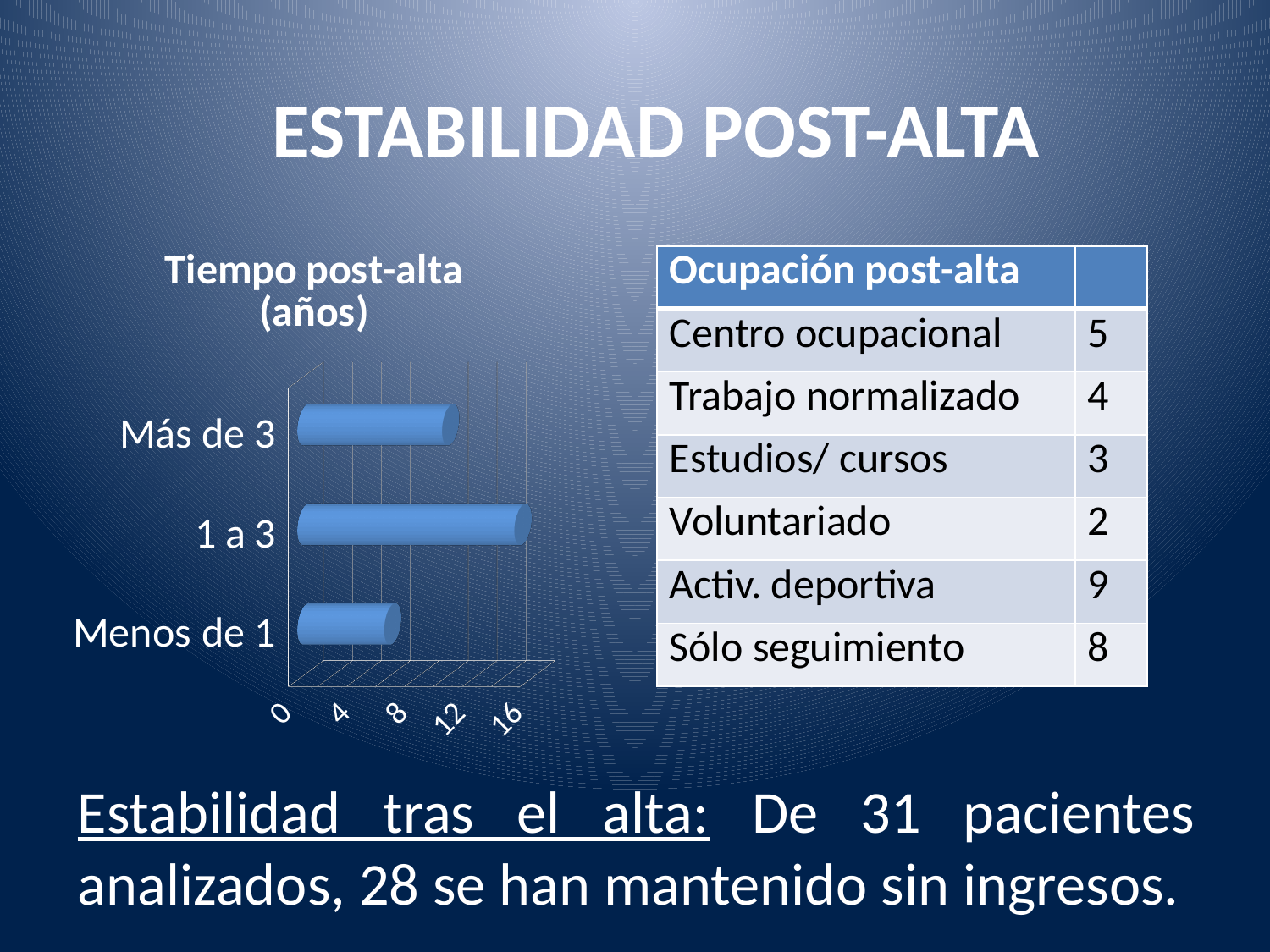
Which category has the lowest value in the "Tiempo post-alta (años)" chart? Menos de 1 What kind of chart is shown under the title "Tiempo post-alta (años)"? bar chart How many categories does the "Tiempo post-alta (años)" chart show? 3 In the "Tiempo post-alta (años)" chart, is the value for "Menos de 1" greater or less than 12? less What is the title of the chart on the slide? Tiempo post-alta (años) In the "Tiempo post-alta (años)" chart, is the value for "Menos de 1" greater or less than 4? greater In the "Tiempo post-alta (años)" chart, is the value for "1 a 3" greater or less than 12? greater In the "Tiempo post-alta (años)" chart, which is larger: the value for "1 a 3" or the value for "Más de 3"? 1 a 3 What is the highest tick value shown on the value axis of the "Tiempo post-alta (años)" chart? 16 Which category has the highest value in the "Tiempo post-alta (años)" chart? 1 a 3 In the "Tiempo post-alta (años)" chart, which is larger: the value for "Más de 3" or the value for "Menos de 1"? Más de 3